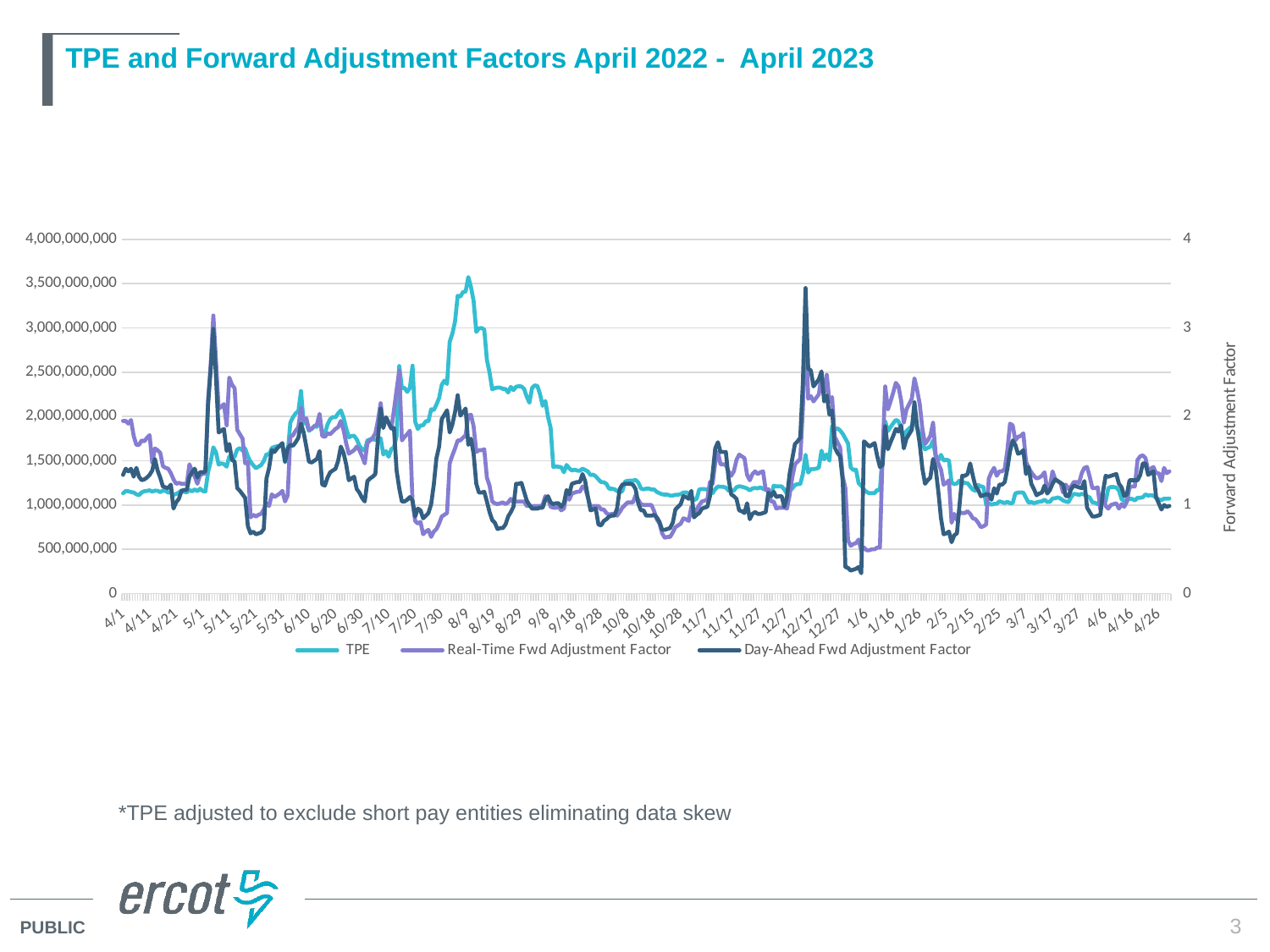
What is the label of the right-hand vertical axis? Forward Adjustment Factor Does the TPE line rise or fall between 8/9 and 9/18? fall What kind of chart is shown on the slide? line chart Is the lowest value of the Day-Ahead Fwd Adjustment Factor around 1/6 greater or less than 0.5? less Which series is drawn in the lightest (cyan) colour? TPE Is the peak value of the TPE line around 8/9 greater or less than 3,000,000,000? greater How many series does the legend list? 3 Is the TPE value at 4/1 greater or less than 1,500,000,000? less What is the title of the chart? TPE and Forward Adjustment Factors April 2022 - April 2023